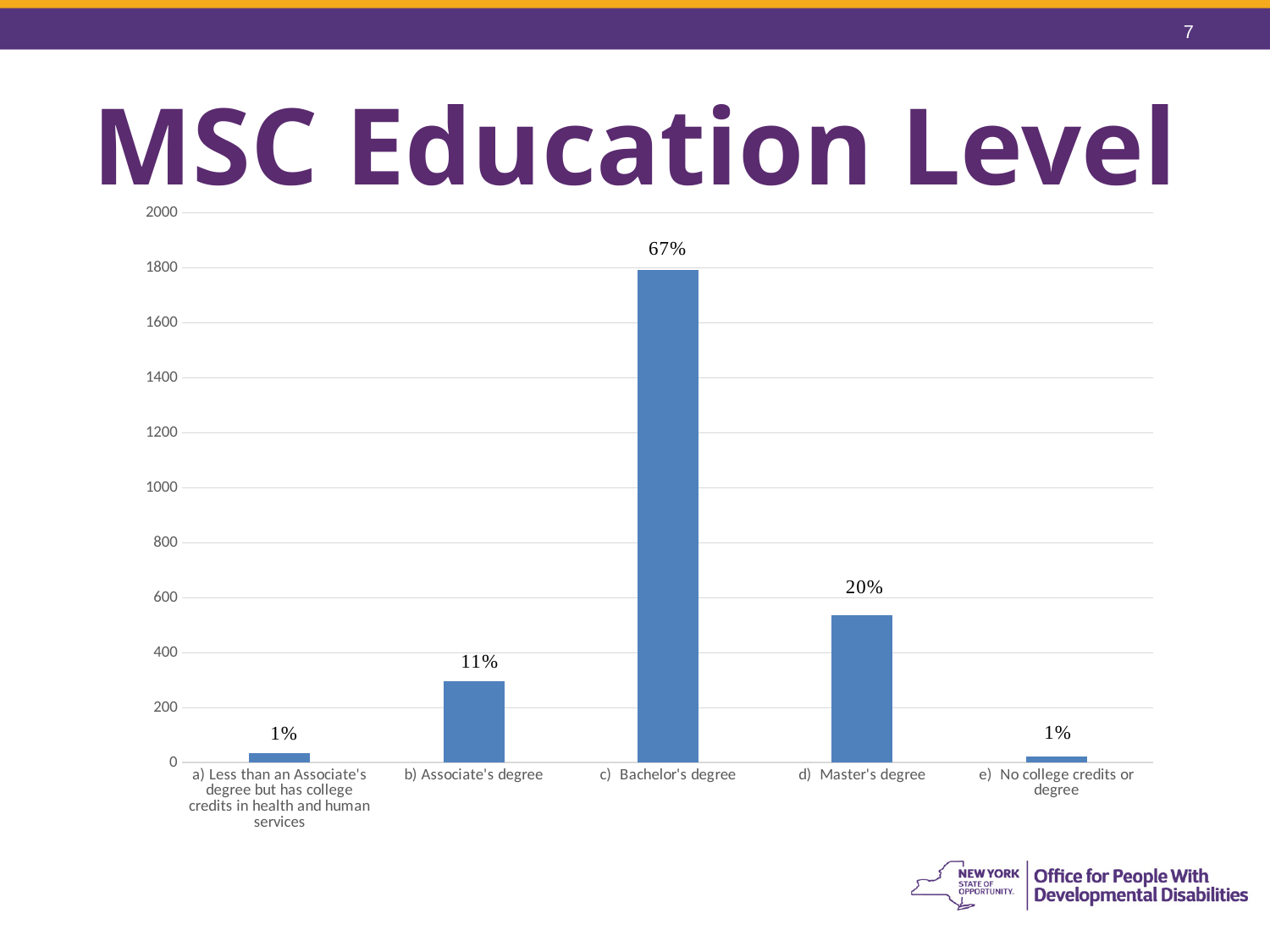
Is the value for b) Associate's degree greater or less than 200? greater Is the value for c) Bachelor's degree greater or less than 1600? greater What percentage label is shown on the bar for b) Associate's degree? 11% Which education level category has the highest bar? c) Bachelor's degree What is the title of the slide containing the chart? MSC Education Level What kind of chart is shown on the slide? Bar chart How many education level categories are shown on the x axis? 5 Is the value for d) Master's degree greater or less than 600? less What percentage label is shown on the bar for d) Master's degree? 20% Which is larger, the bar for d) Master's degree or the bar for b) Associate's degree? d) Master's degree What percentage label is shown on the bar for c) Bachelor's degree? 67% What percentage label is shown on the bar for e) No college credits or degree? 1%